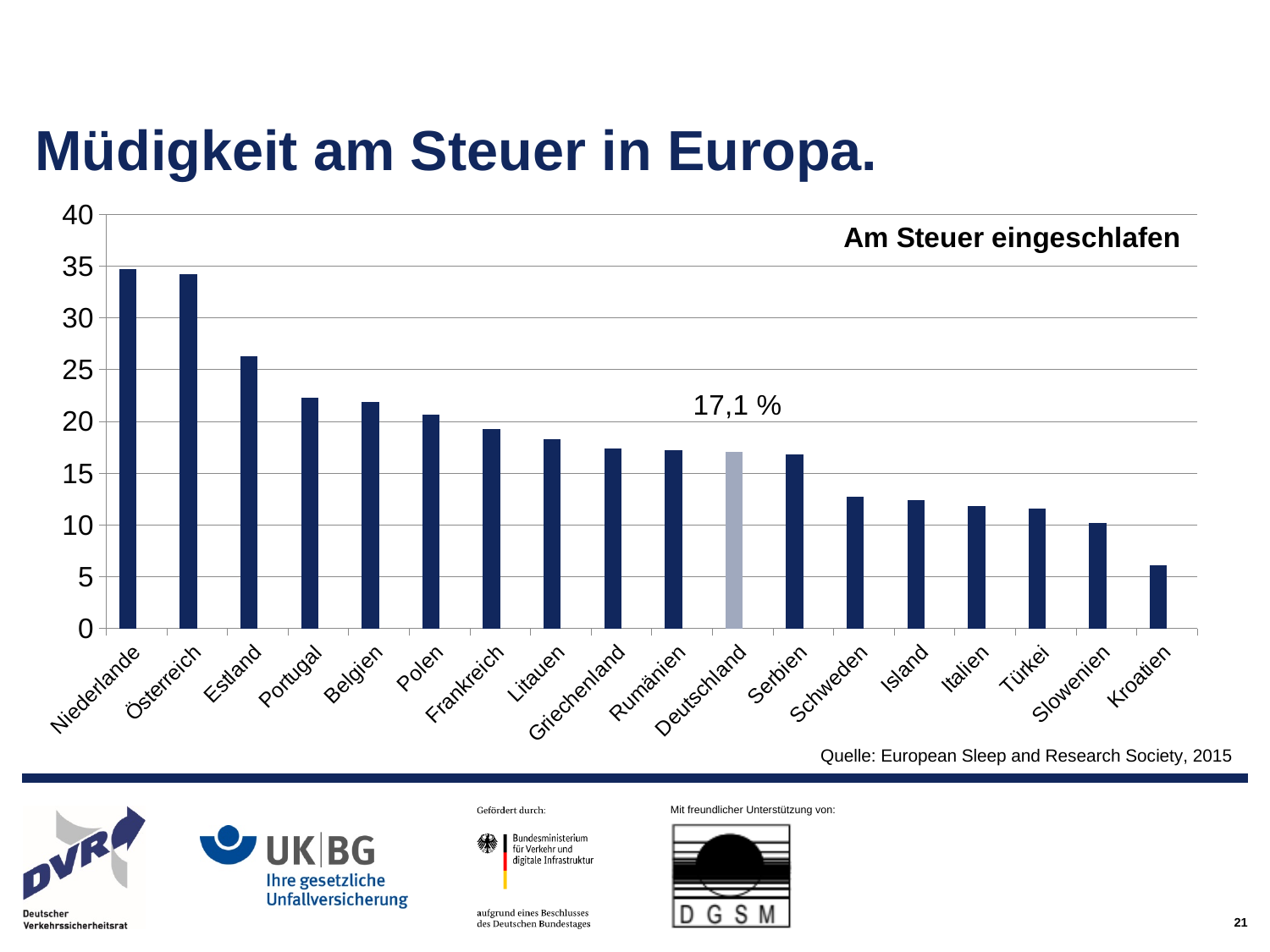
What value is labelled on the bar for Deutschland? 17,1 % Is the value for Kroatien greater or less than 10? less Which country has the lowest bar in the chart? Kroatien Do the values rise or fall from left to right along the x axis? Fall Is the value for Niederlande greater or less than 30? greater Which has the larger value, Estland or Portugal? Estland What kind of chart is shown on the slide? Bar chart How many countries are shown on the x axis of the chart? 18 Which has the larger value, Deutschland or Schweden? Deutschland Which country has the highest bar in the chart? Niederlande What is the title of the slide containing the chart? Müdigkeit am Steuer in Europa. Is the value for Serbien greater or less than 20? less